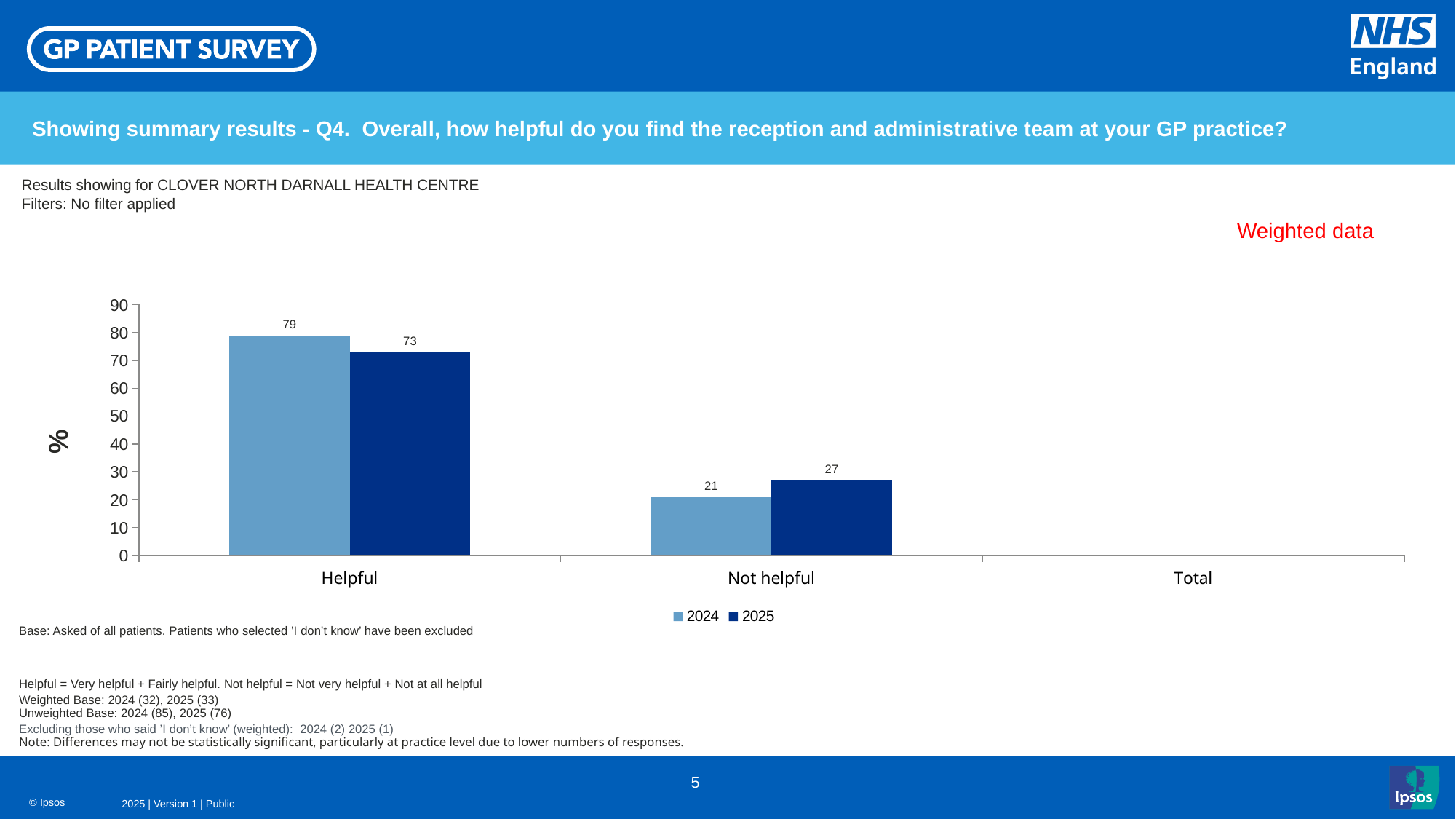
What is the label on the vertical axis of the chart? % What is the value for Not helpful in 2024? 21 How many series does the legend list? 2 Which is larger for Not helpful: the 2024 value or the 2025 value? 2025 What is the value for Helpful in 2025? 73 What is the difference between the 2025 and 2024 values for Not helpful? 6 What is the value for Not helpful in 2025? 27 What kind of chart is shown on the slide? Bar chart What is the value for Helpful in 2024? 79 Which category has the highest value for the 2025 series? Helpful Which category has the lowest value for the 2024 series? Not helpful What is the difference between the 2024 and 2025 values for Helpful? 6